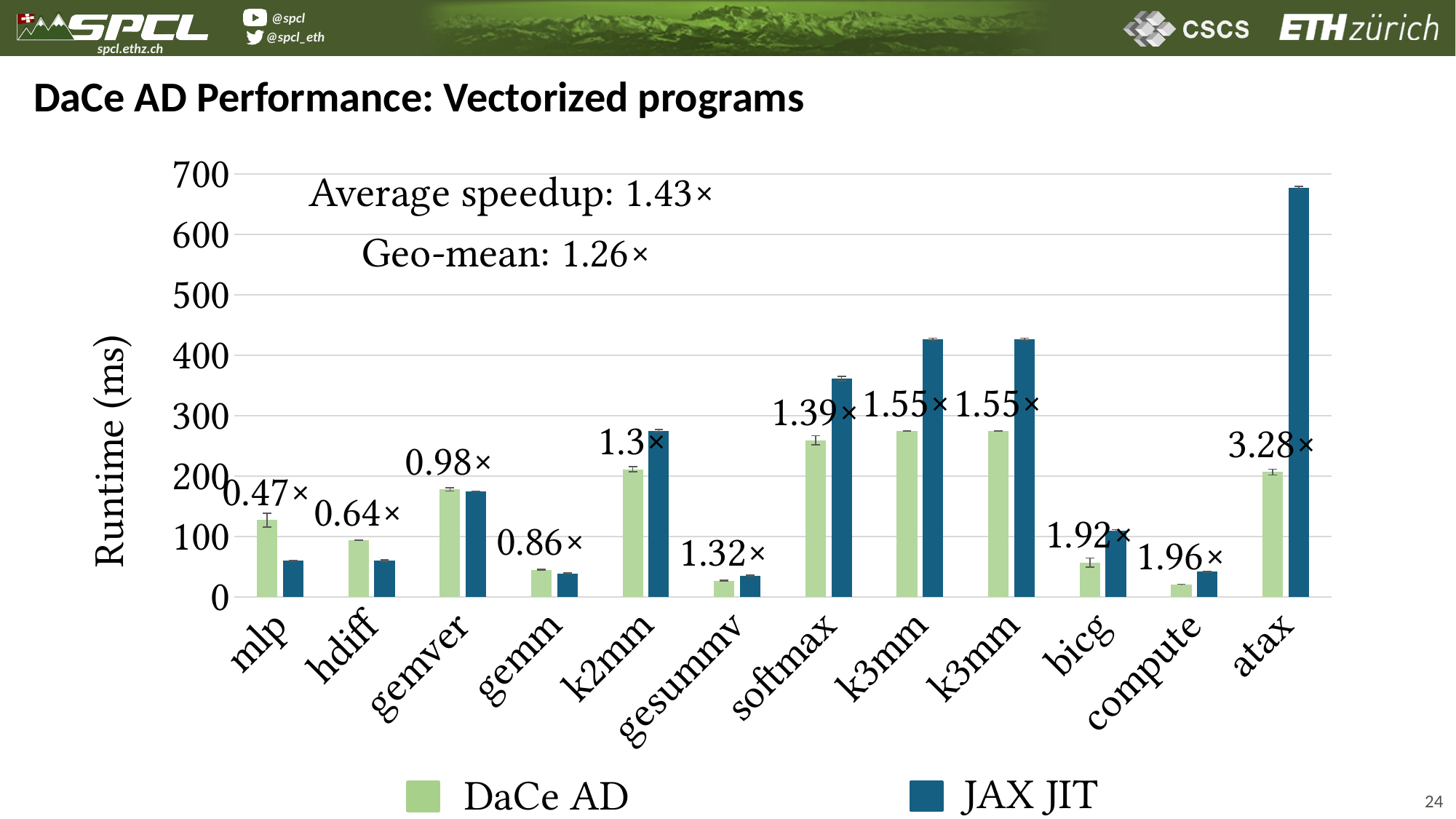
Which category has the lowest labelled speedup? mlp What kind of chart is shown on the slide? bar chart Which category has the highest labelled speedup? atax What speedup is labelled for bicg? 1.92× What speedup is labelled for mlp? 0.47× Is the DaCe AD runtime for compute greater or less than 100? less What average speedup is stated on the chart? 1.43× Is the JAX JIT runtime for atax greater or less than 600? greater For mlp, which series has the larger runtime, DaCe AD or JAX JIT? DaCe AD What speedup is labelled for atax? 3.28× How many categories are shown on the x axis? 12 How many series does the legend list? 2